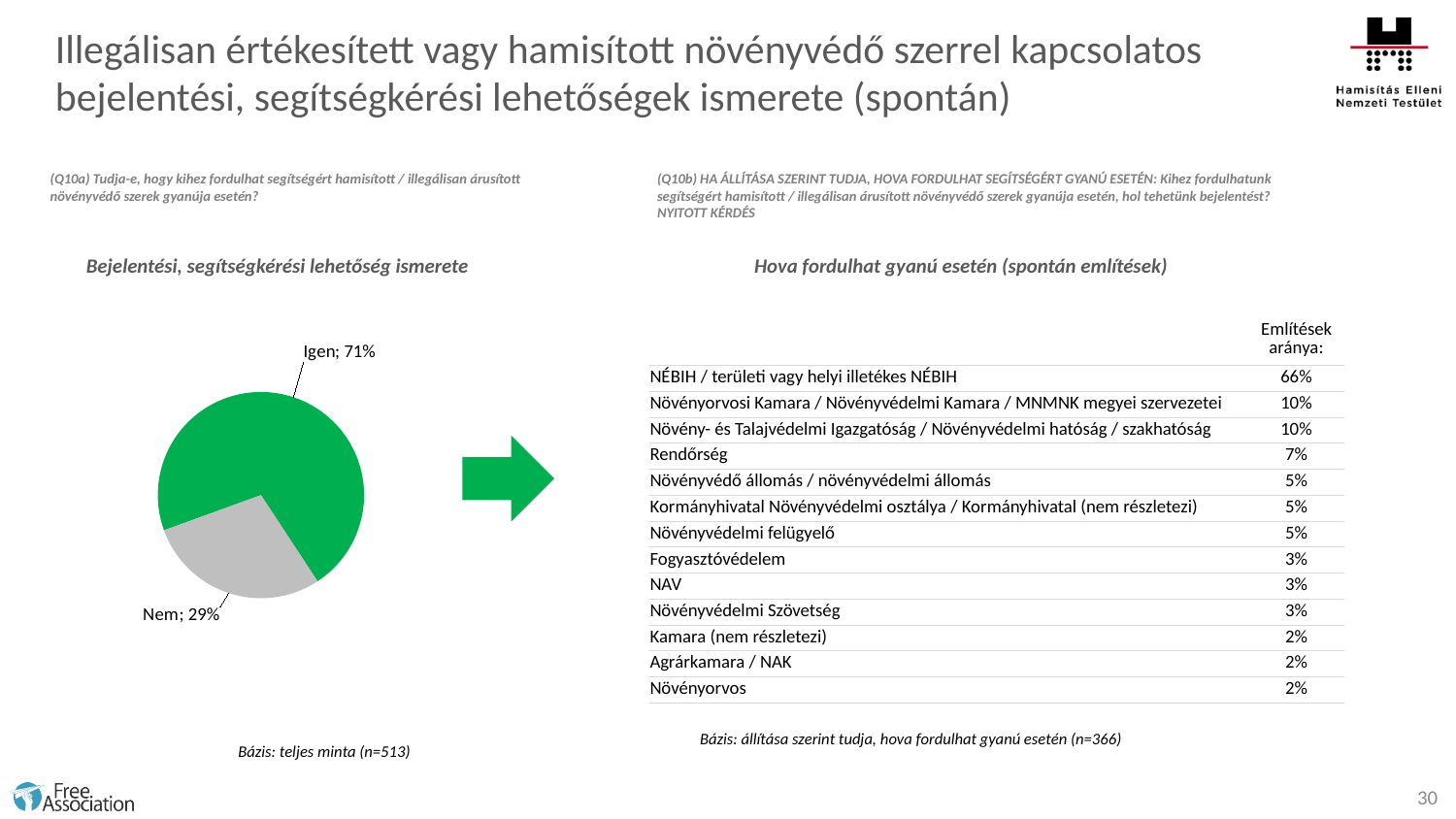
Which slice of the pie chart is the largest? Igen What is the value for "Nem" in the pie chart? 29% How many slices does the pie chart have? 2 What colour is the "Igen" slice of the pie chart? green What kind of chart is shown on the slide? pie chart Which is larger in the pie chart, "Igen" or "Nem"? Igen What is the value for "Igen" in the pie chart? 71% Is the value for "Igen" in the pie chart greater or less than 50%? greater Which slice of the pie chart is the smallest? Nem What share of the pie does the "Nem" slice represent? 29% What is the title above the pie chart? Bejelentési, segítségkérési lehetőség ismerete What is the difference in percentage points between "Igen" and "Nem" in the pie chart? 42